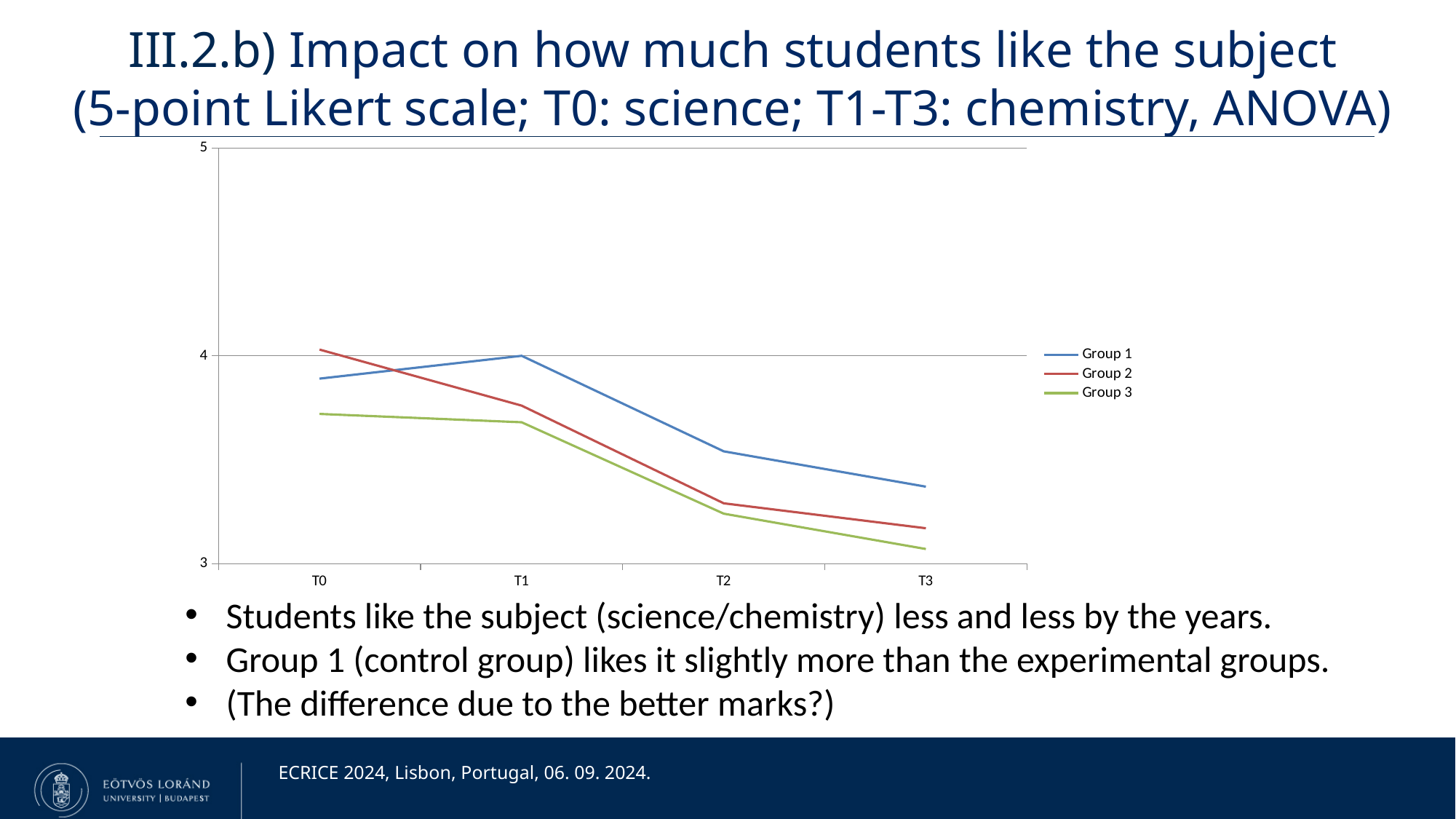
At T2, which is larger: the value for Group 1 or Group 2? Group 1 At which time point does Group 1 reach its highest value? T1 Does the value for Group 3 rise or fall from T0 to T3? fall Which group has the highest value at T3? Group 1 How many time points are shown on the x axis? 4 How many series does the legend list? 3 Which series is drawn in green? Group 3 Is the value for Group 3 at T0 greater or less than 4? less At which time point is Group 2 at its lowest value? T3 At T0, which is larger: the value for Group 2 or Group 3? Group 2 Which group has the lowest value at T3? Group 3 What kind of chart is shown on the slide? line chart